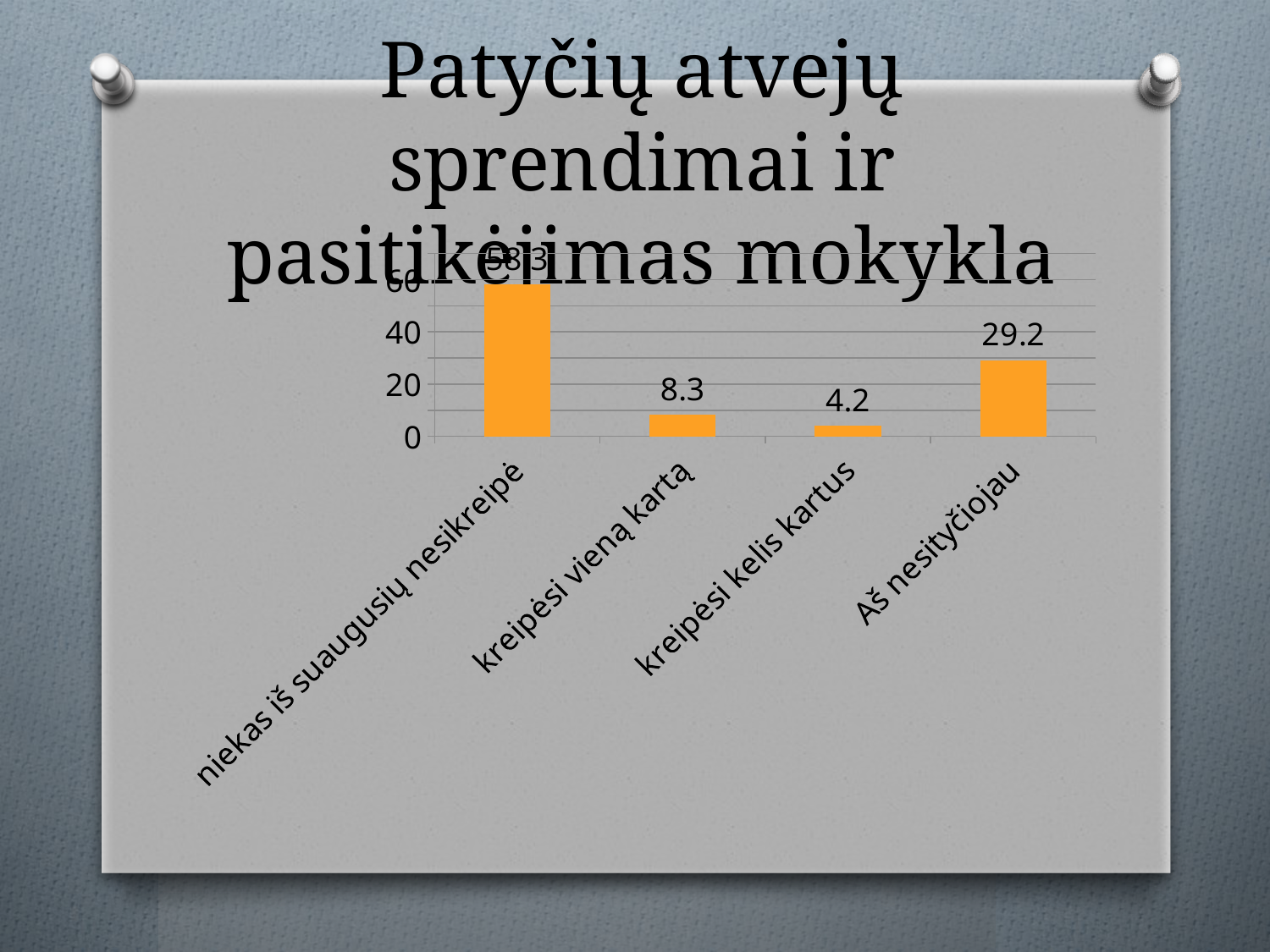
Which category has the lowest value? kreipėsi kelis kartus What is the value for "Aš nesityčiojau"? 29.2 How many categories are shown in the chart? 4 Which is larger, the value for "Aš nesityčiojau" or the value for "kreipėsi vieną kartą"? Aš nesityčiojau Which category has the highest value? niekas iš suaugusių nesikreipė What type of chart is shown on the slide? bar chart What is the value for "kreipėsi kelis kartus"? 4.2 What is the difference between the values for "kreipėsi vieną kartą" and "kreipėsi kelis kartus"? 4.1 What colour are the bars in the chart? orange What is the value for "kreipėsi vieną kartą"? 8.3 What is the difference between the values for "Aš nesityčiojau" and "kreipėsi vieną kartą"? 20.9 Is the value for "niekas iš suaugusių nesikreipė" greater or less than 40? greater